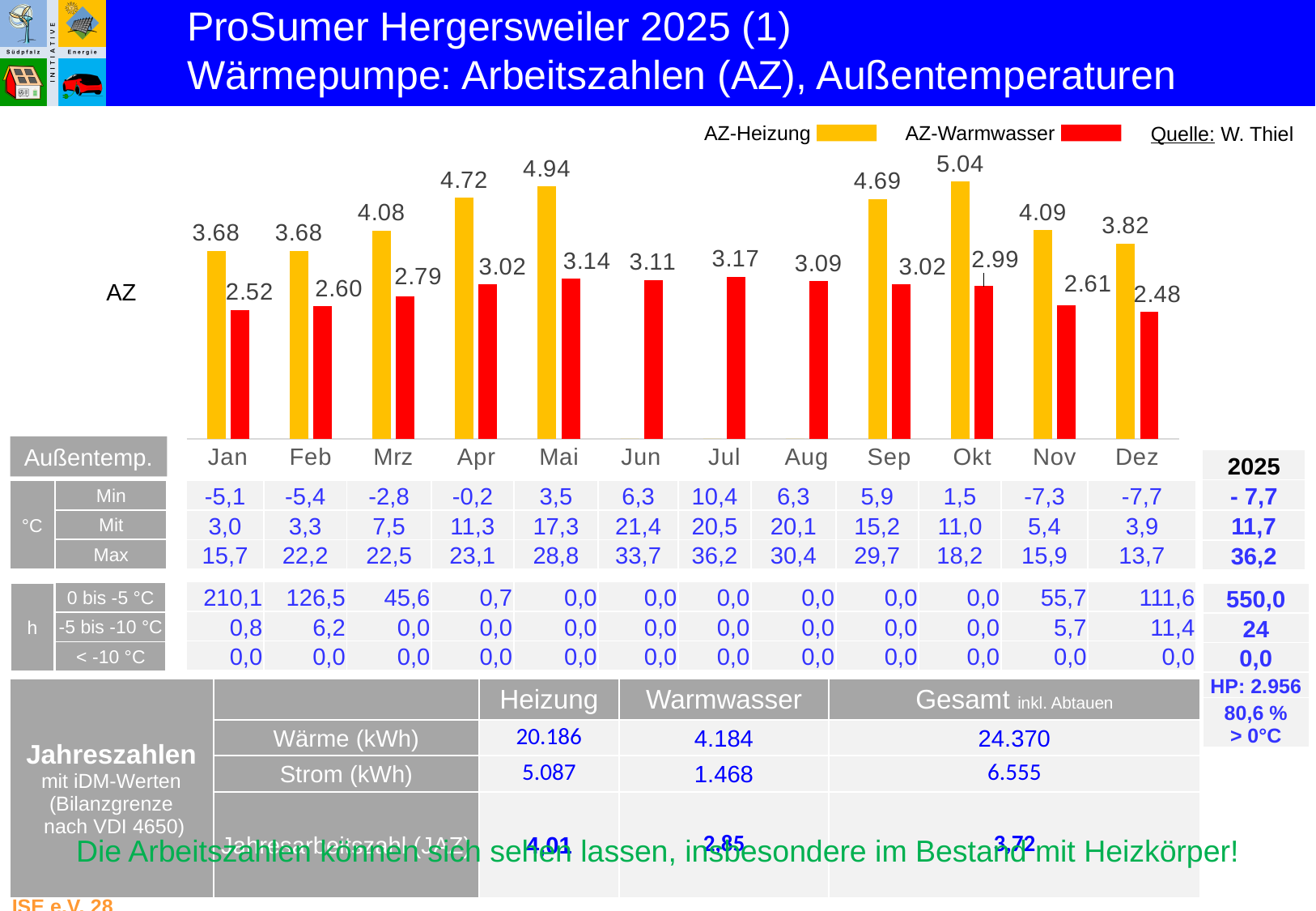
What kind of chart is used to show the AZ values? Bar chart What is the AZ-Heizung value for Okt? 5.04 What is the AZ-Warmwasser value for Jan? 2.52 Which is larger, the AZ-Heizung value for Apr or for Sep? Apr How many series does the chart legend list? 2 Which month has the highest AZ-Warmwasser value? Jul What is the AZ-Heizung value for Mai? 4.94 Which colour represents AZ-Warmwasser in the chart? Red Which month has the lowest AZ-Warmwasser value? Dez How many months are shown on the x axis of the chart? 12 Which month has the highest AZ-Heizung value? Okt What is the difference between the AZ-Heizung and AZ-Warmwasser values in Okt? 2.05